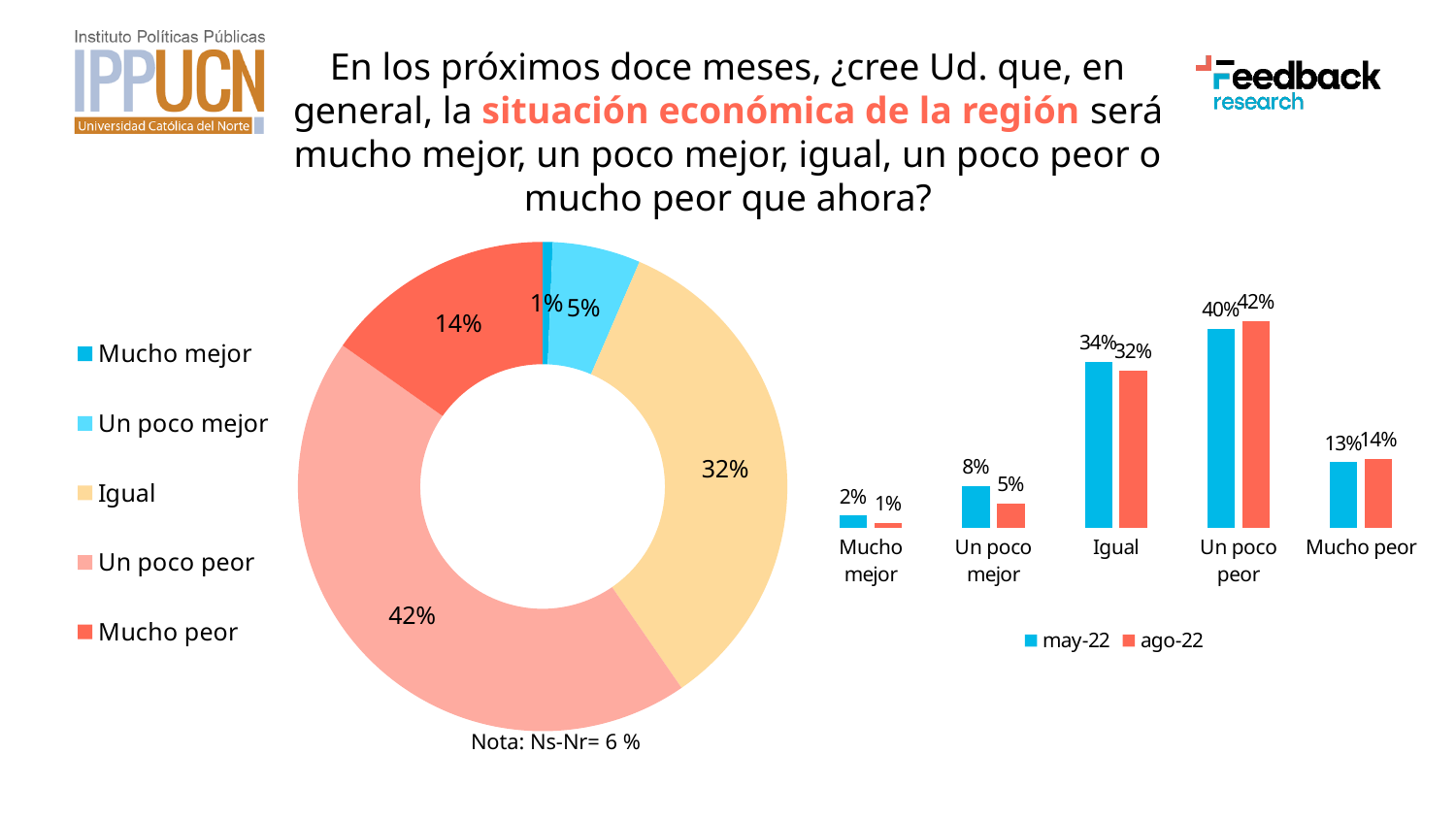
In the donut chart on the left, how many categories does the legend list? 5 In the bar chart on the right, what is the difference between the ago-22 and may-22 values for "Un poco peor"? 2% In the bar chart on the right, what is the value for "Igual" in may-22? 34% In the donut chart on the left, what share is shown for "Igual"? 32% In the bar chart on the right, how many series does the legend list? 2 In the donut chart on the left, what share is shown for "Un poco peor"? 42% In the donut chart on the left, which category has the largest share? Un poco peor In the bar chart on the right, which is larger for "Un poco mejor": may-22 or ago-22? may-22 In the bar chart on the right, which category has the highest ago-22 value? Un poco peor What type of chart is shown on the right side of the slide? Bar chart In the donut chart on the left, which category has the smallest share? Mucho mejor In the bar chart on the right, what is the value for "Un poco mejor" in ago-22? 5%